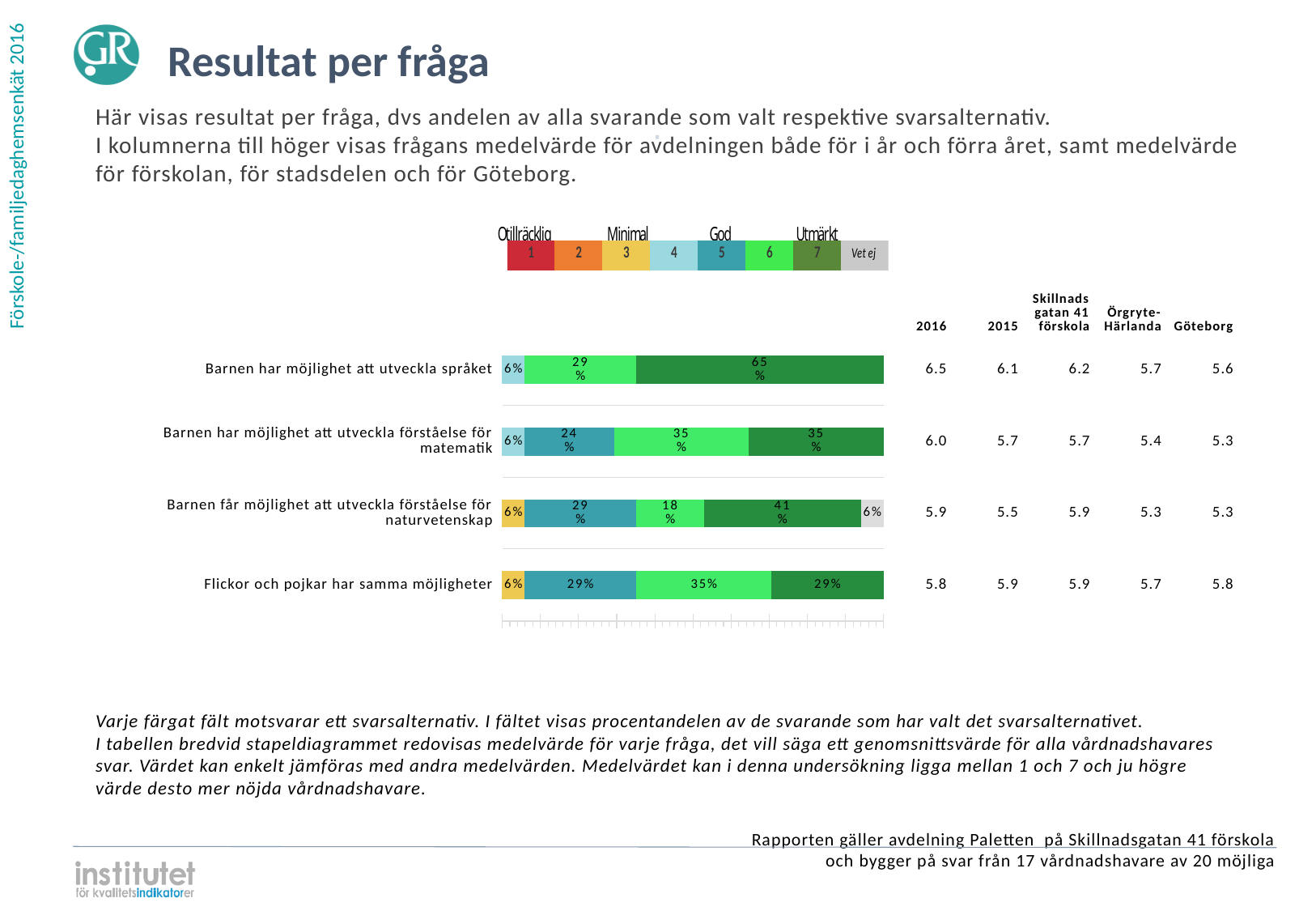
What kind of chart is shown on the slide? Stacked bar chart What percentage chose answer 5 (teal) for 'Barnen har möjlighet att utveckla förståelse för matematik'? 24% How many answer alternatives does the legend above the chart list? 8 How many questions (categories) are plotted in the bar chart? 4 Which question has the largest share of answer 7 (dark green)? Barnen har möjlighet att utveckla språket What percentage of respondents chose answer 7 (dark green) for 'Barnen har möjlighet att utveckla språket'? 65% What percentage answered 'Vet ej' for 'Barnen får möjlighet att utveckla förståelse för naturvetenskap'? 6% What is the title of the slide? Resultat per fråga What is the difference in percentage points between the answer 7 share and the answer 6 share for 'Barnen har möjlighet att utveckla språket'? 36 percentage points Which is larger for 'Flickor och pojkar har samma möjligheter': the share for answer 6 or the share for answer 7? Answer 6 (35%) What is the 2016 mean value shown for 'Barnen har möjlighet att utveckla språket'? 6.5 What percentage chose answer 6 (light green) for 'Barnen får möjlighet att utveckla förståelse för naturvetenskap'? 18%